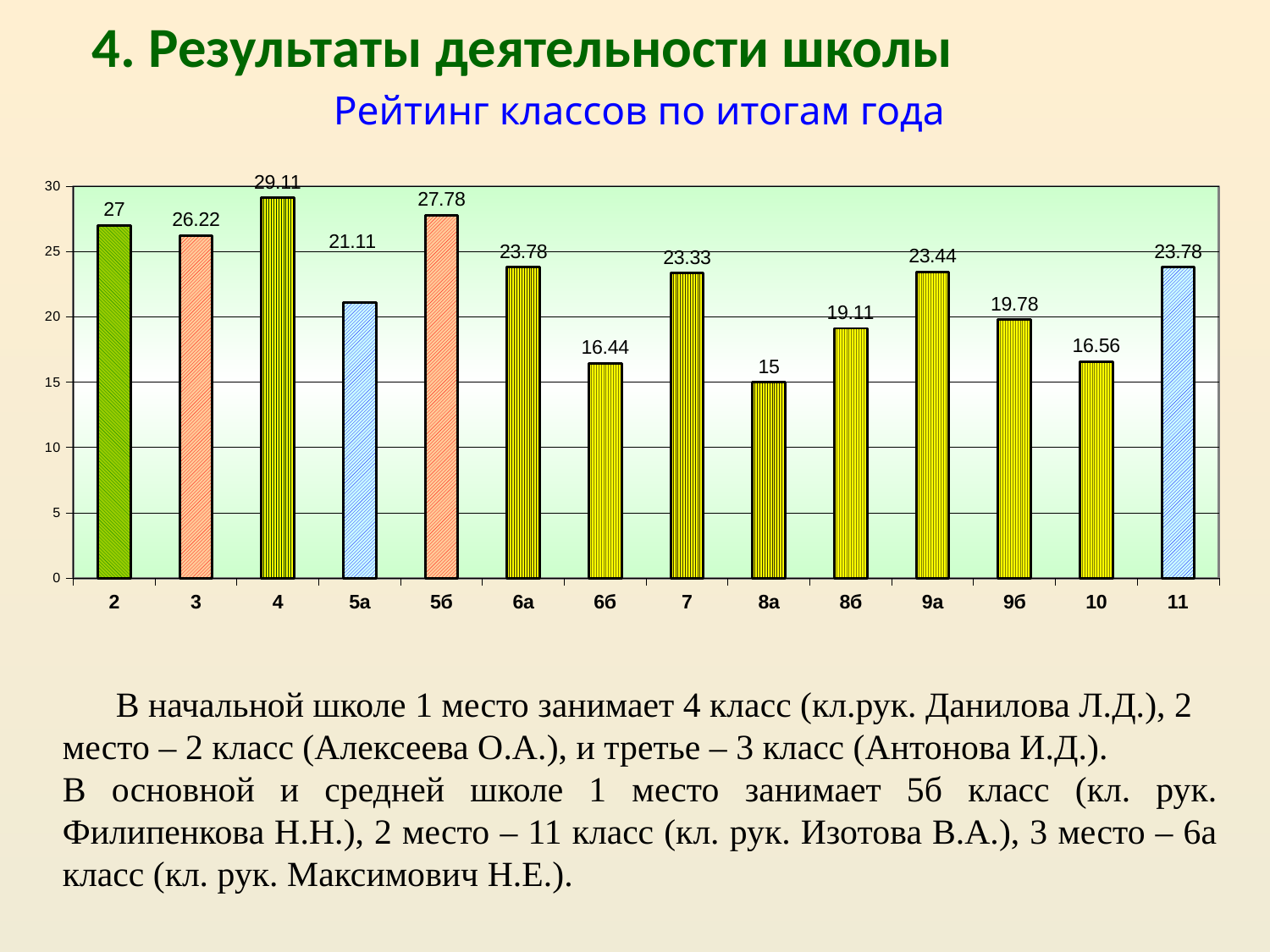
Is the value for class 5а greater or less than 20? greater Which class has the highest value? 4 What is the difference between the values for class 5б and class 11? 4 What is the value for class 5б? 27.78 What kind of chart is shown on the slide? Bar chart Which class has the lowest value? 8а Which has a larger value, class 6б or class 9б? 9б What is the value for class 8б? 19.11 What is the difference between the values for class 4 and class 2? 2.11 What is the value for class 4? 29.11 What is the title of the chart? Рейтинг классов по итогам года How many classes are shown on the x axis? 14